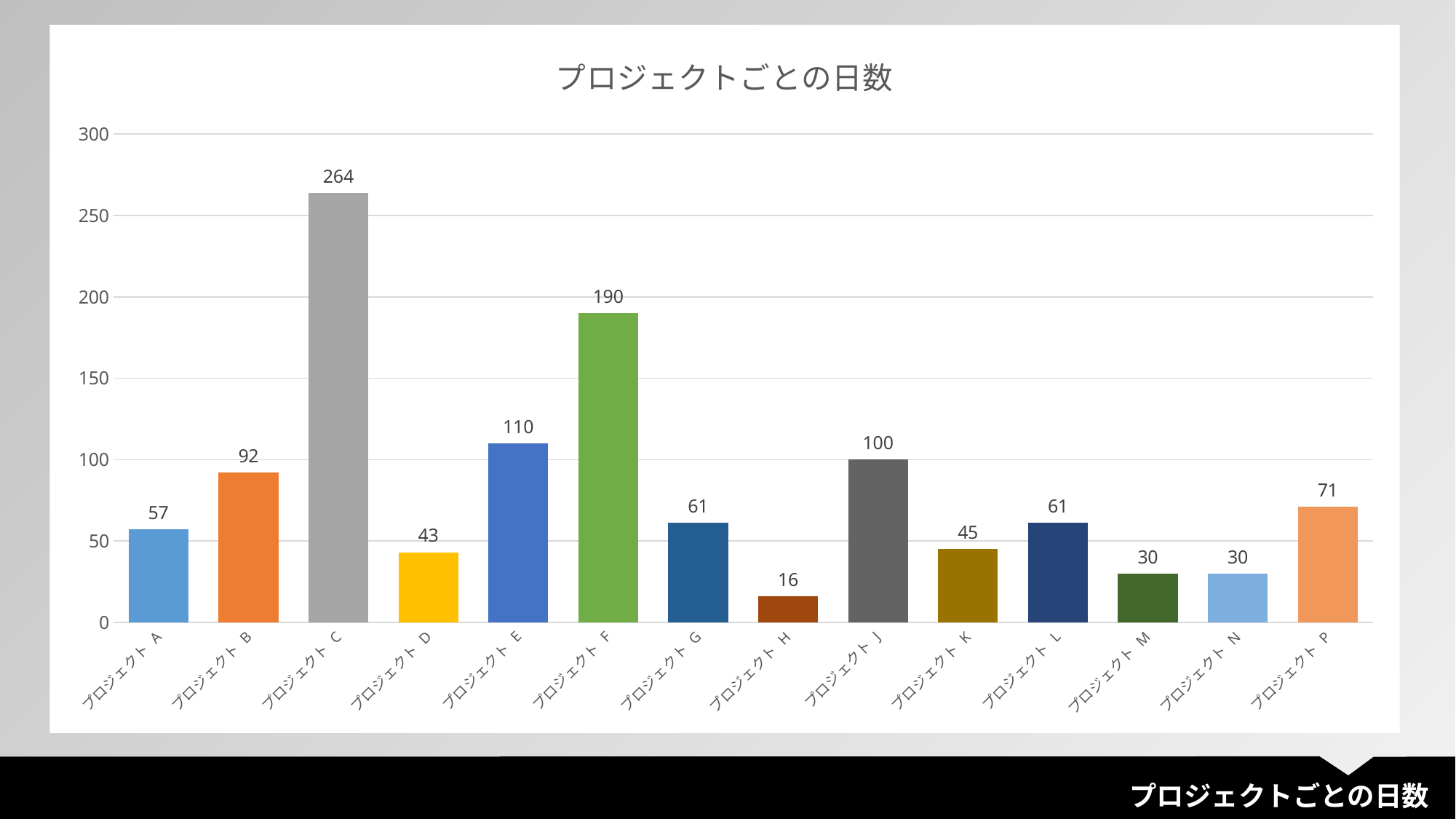
Which is larger, the value for プロジェクト P or the value for プロジェクト G? プロジェクト P Is the value for プロジェクト F greater or less than 150? greater What is the difference between the values for プロジェクト C and プロジェクト F? 74 How many projects are shown on the x axis? 14 What kind of chart is shown on the slide? bar chart Which project has the lowest value? プロジェクト H What is the value for プロジェクト H? 16 What is the value for プロジェクト J? 100 What is the title of the chart? プロジェクトごとの日数 What is the value for プロジェクト C? 264 What is the difference between the values for プロジェクト E and プロジェクト B? 18 Which project has the highest value? プロジェクト C